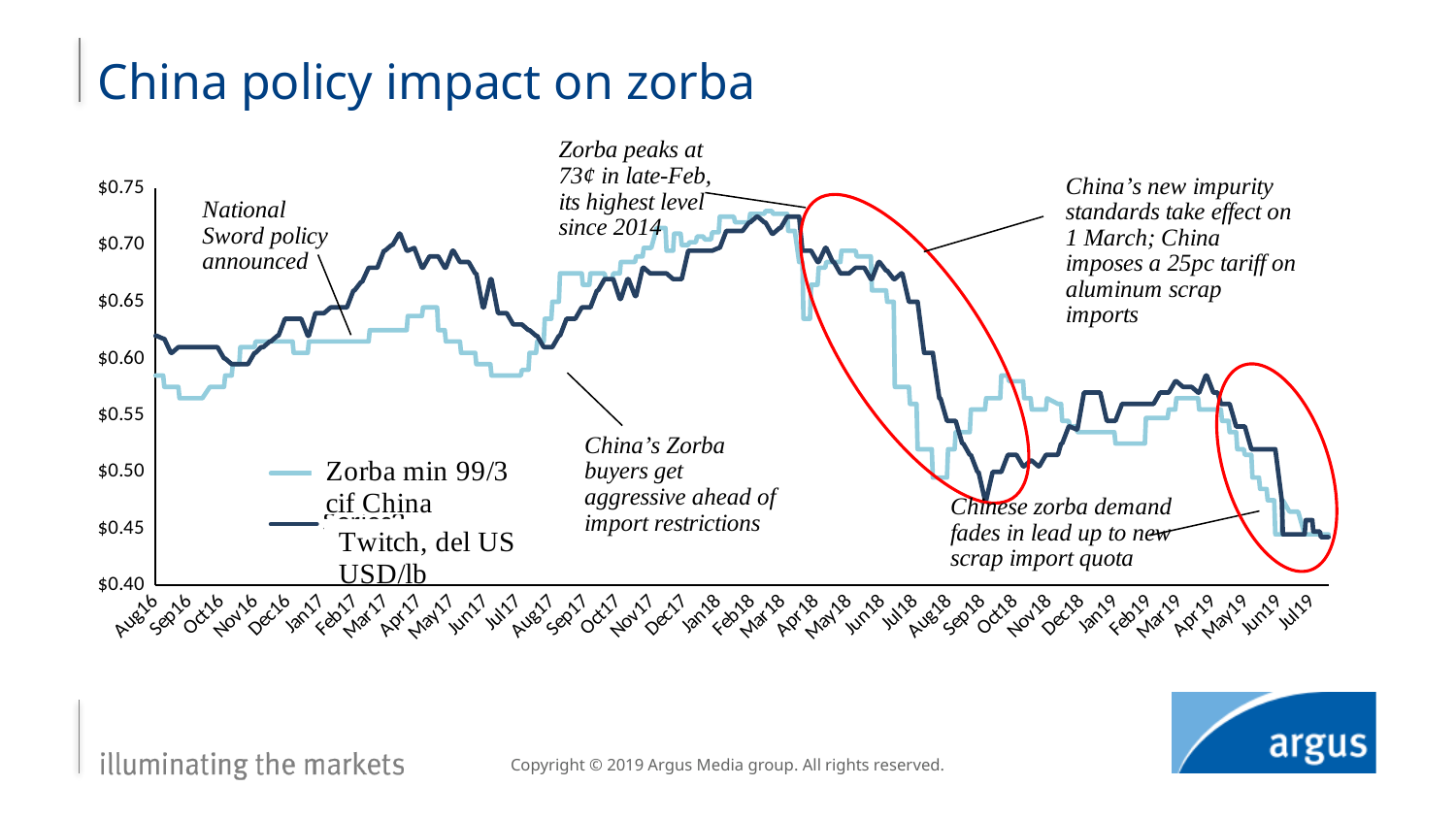
Is the value for Zorba min 99/3 cif China in Sep16 greater or less than $0.60? less Is the value for Zorba min 99/3 cif China in Jul19 greater or less than $0.50? less In Mar17, which series has the higher value, Zorba min 99/3 cif China or Twitch, del US USD/lb? Twitch, del US USD/lb How many series does the chart's legend list? 2 Is the value for Twitch, del US USD/lb in Mar17 greater or less than $0.65? greater Does the Zorba min 99/3 cif China series rise or fall between Apr18 and Sep18? fall What kind of chart is shown on the slide? line chart What are the two series named in the legend? Zorba min 99/3 cif China; Twitch, del US USD/lb Does the Zorba min 99/3 cif China series rise or fall between Aug17 and Feb18? rise In Jul18, which series has the higher value, Zorba min 99/3 cif China or Twitch, del US USD/lb? Twitch, del US USD/lb What is the title of the chart slide? China policy impact on zorba